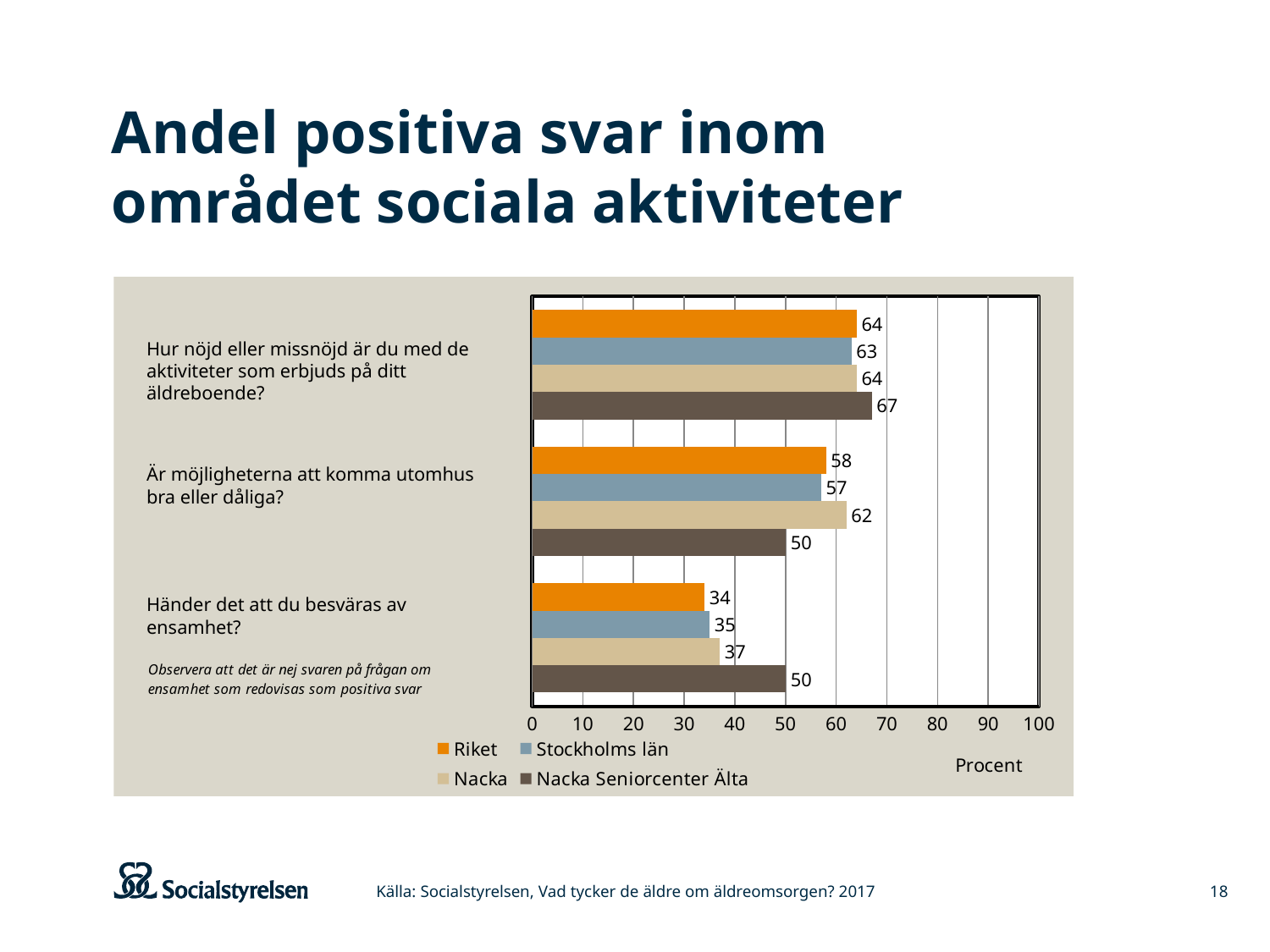
What is the value for Nacka Seniorcenter Älta on the question "Hur nöjd eller missnöjd är du med de aktiviteter som erbjuds på ditt äldreboende?"? 67 What kind of chart is shown on the slide? Bar chart Which series has the highest value on the question "Händer det att du besväras av ensamhet?"? Nacka Seniorcenter Älta What is the value for Riket on the question "Händer det att du besväras av ensamhet?"? 34 What is the value for Nacka on the question "Är möjligheterna att komma utomhus bra eller dåliga?"? 62 How many question categories are plotted on the chart? 3 Which series has the lowest value on the question "Är möjligheterna att komma utomhus bra eller dåliga?"? Nacka Seniorcenter Älta What is the difference between the Nacka Seniorcenter Älta value and the Riket value on the question "Händer det att du besväras av ensamhet?"? 16 Which is larger on the question "Händer det att du besväras av ensamhet?": the value for Nacka or the value for Stockholms län? Nacka How many series does the legend list? 4 What label is shown on the horizontal axis of the chart? Procent What is the difference between the Nacka value and the Nacka Seniorcenter Älta value on the question "Är möjligheterna att komma utomhus bra eller dåliga?"? 12